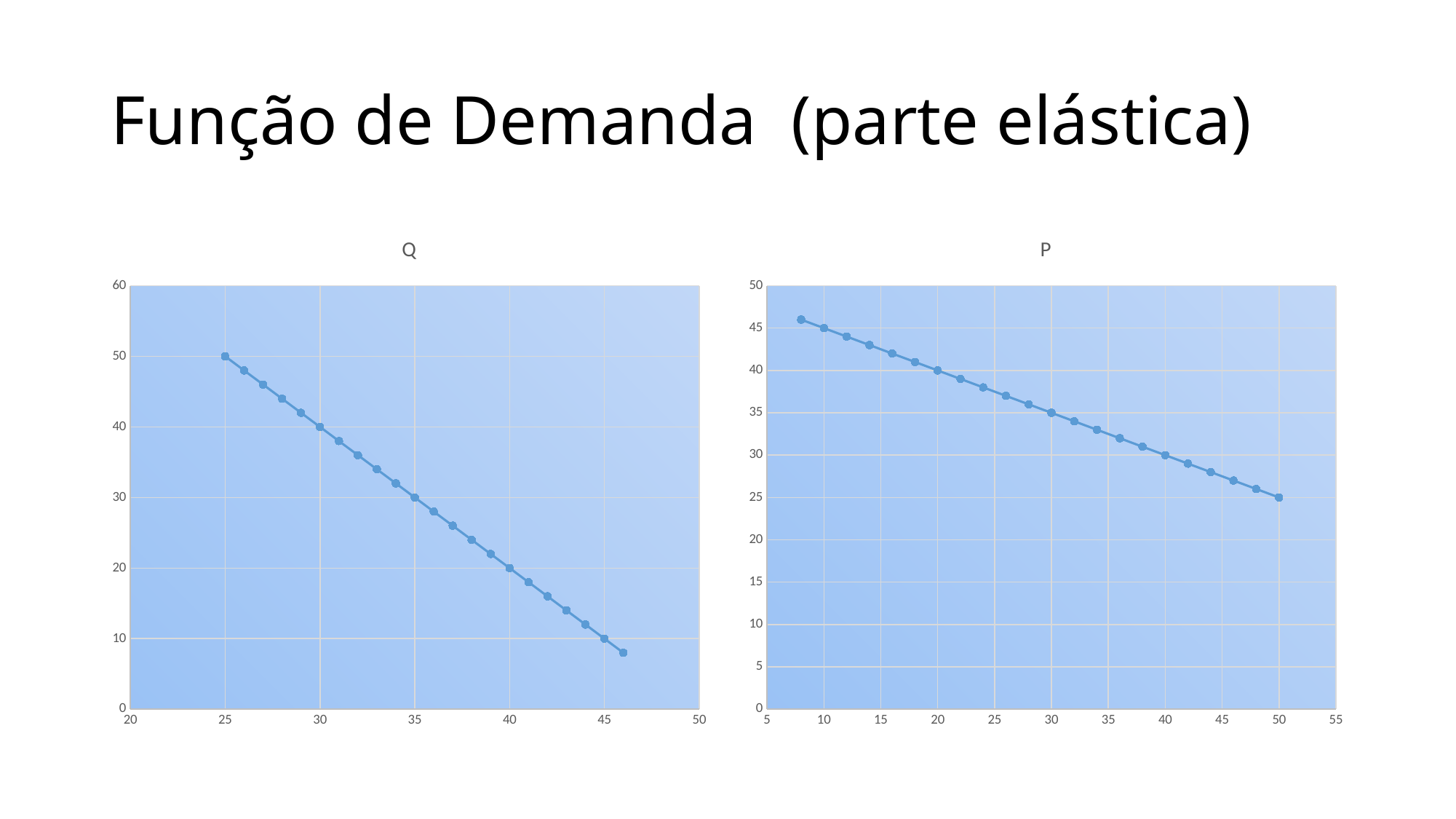
In the chart titled Q, is the y value of the point at x = 43 greater or less than 20? less In the chart titled P, what is the y value of the point at x = 20? 40 In the chart titled Q, what is the difference between the y values at x = 30 and x = 40? 20 In the chart titled Q, do the y values rise or fall as x increases? fall In the chart titled Q, what is the y value of the point at x = 30? 40 What type of chart is the chart titled P? line chart In the chart titled P, which has the larger y value: the point at x = 10 or the point at x = 40? x = 10 In the chart titled Q, at which x value is the y value highest? 25 In the chart titled Q, what is the y value of the point at x = 45? 10 In the chart titled P, what is the y value of the point at x = 50? 25 In the chart titled P, is the y value of the point at x = 14 greater or less than 40? greater In the chart titled Q, what is the y value of the point at x = 25? 50